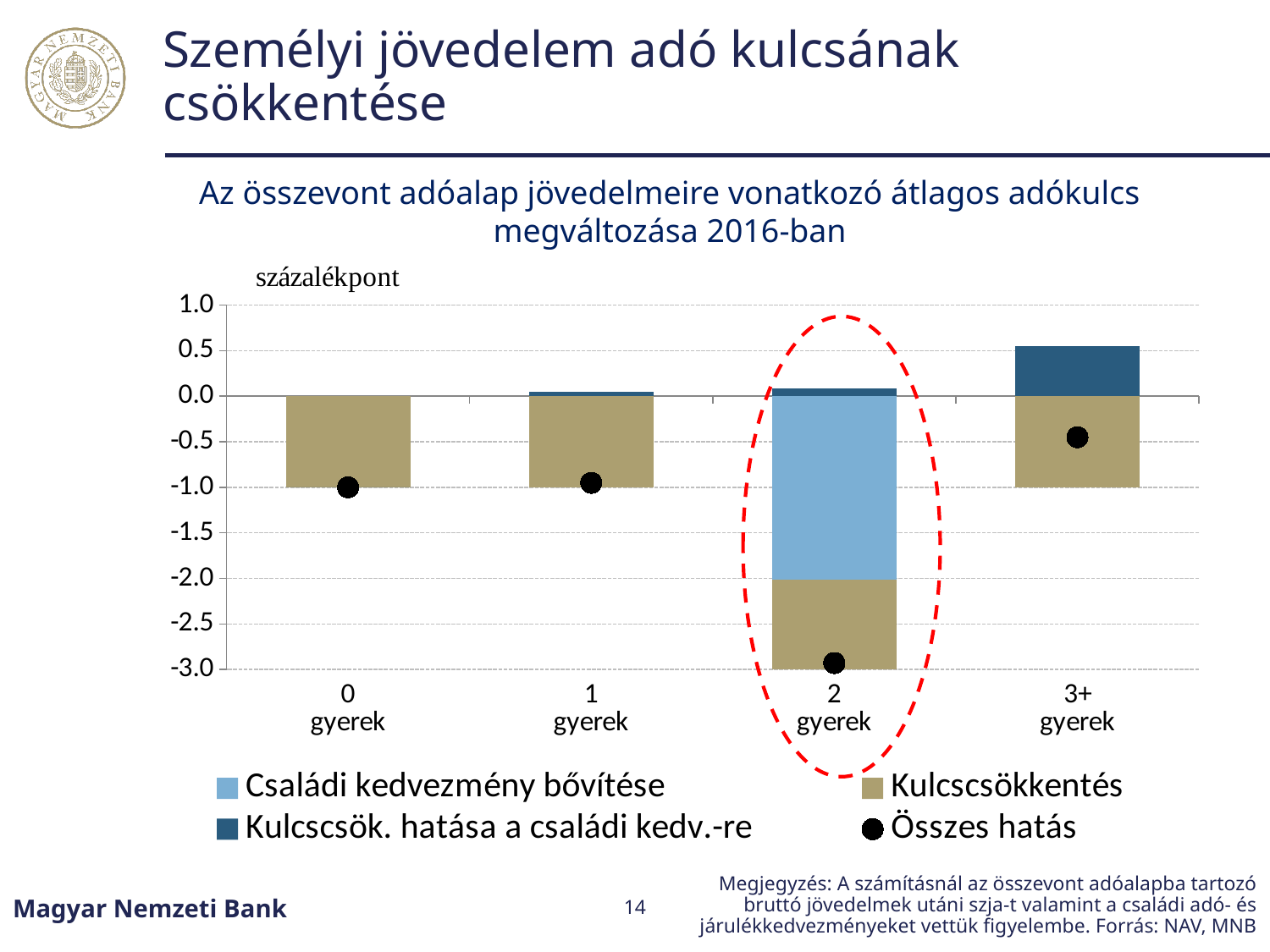
Which category has the largest Családi kedvezmény bővítése segment? 2 gyerek Is the value for Összes hatás for 3+ gyerek greater or less than -1.0? greater What is the title of the chart? Az összevont adóalap jövedelmeire vonatkozó átlagos adókulcs megváltozása 2016-ban How many categories are shown on the x axis of the chart? 4 What unit is shown above the y axis of the chart? százalékpont How many series does the chart's legend list? 4 What kind of chart is shown on the slide? bar chart Which is larger, the Összes hatás value for 3+ gyerek or for 0 gyerek? 3+ gyerek Is the value for Összes hatás for 2 gyerek greater or less than -2.5? less Which category has the highest value for Összes hatás? 3+ gyerek Which category has the lowest value for Összes hatás? 2 gyerek Is the Kulcscsök. hatása a családi kedv.-re value for 3+ gyerek greater or less than 0.0? greater